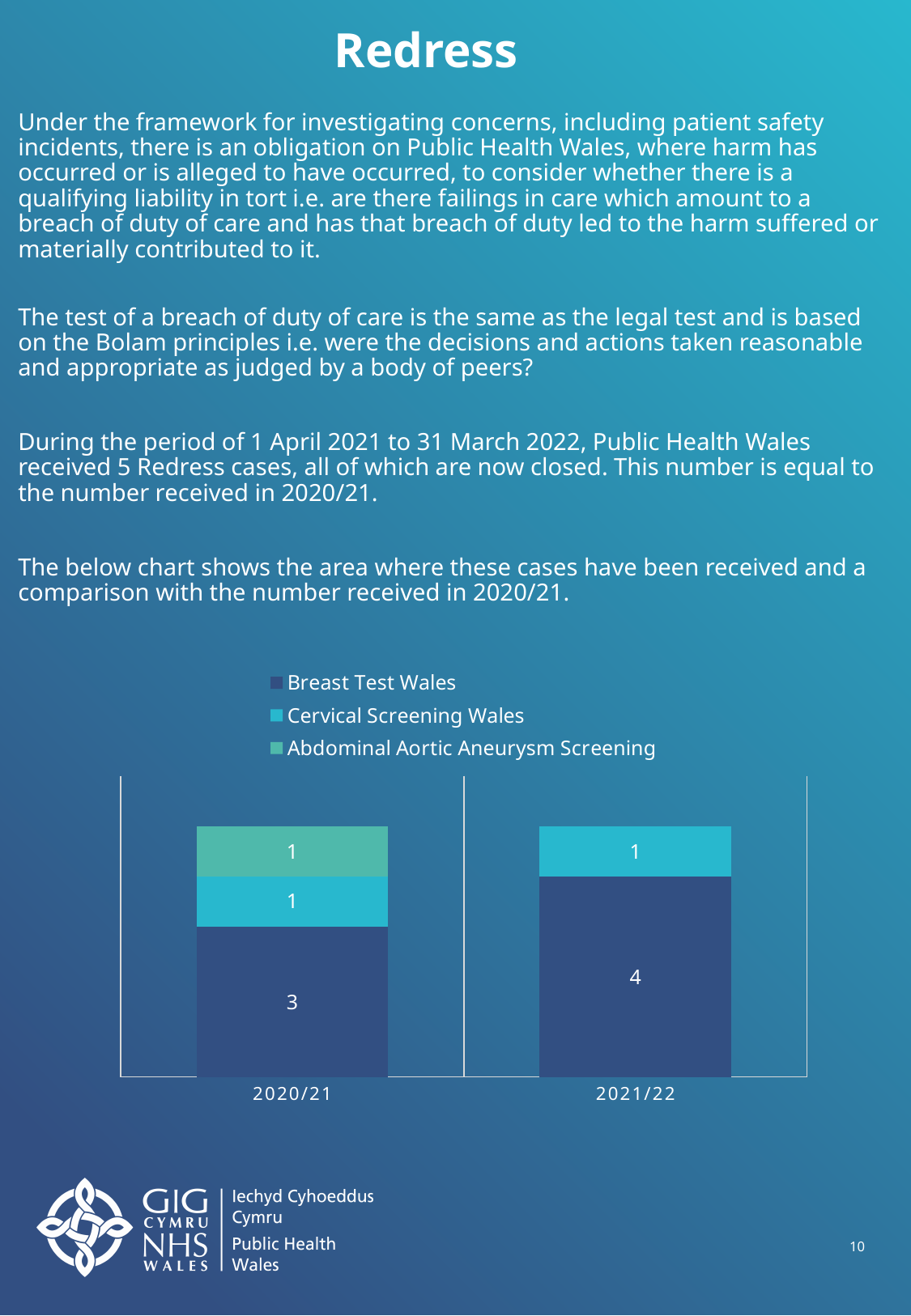
What is the total of the stacked bar for 2021/22? 5 What kind of chart is shown on the slide? Stacked bar chart Which series is listed first in the chart legend? Breast Test Wales What is the value for Breast Test Wales in 2020/21? 3 What is the value for Breast Test Wales in 2021/22? 4 What is the total of the stacked bar for 2020/21? 5 What is the value for Cervical Screening Wales in 2021/22? 1 Which year has the larger value for Breast Test Wales, 2020/21 or 2021/22? 2021/22 What is the value for Abdominal Aortic Aneurysm Screening in 2020/21? 1 What is the difference between the Breast Test Wales values for 2021/22 and 2020/21? 1 How many series does the chart legend list? 3 How many categories are shown on the x axis of the chart? 2